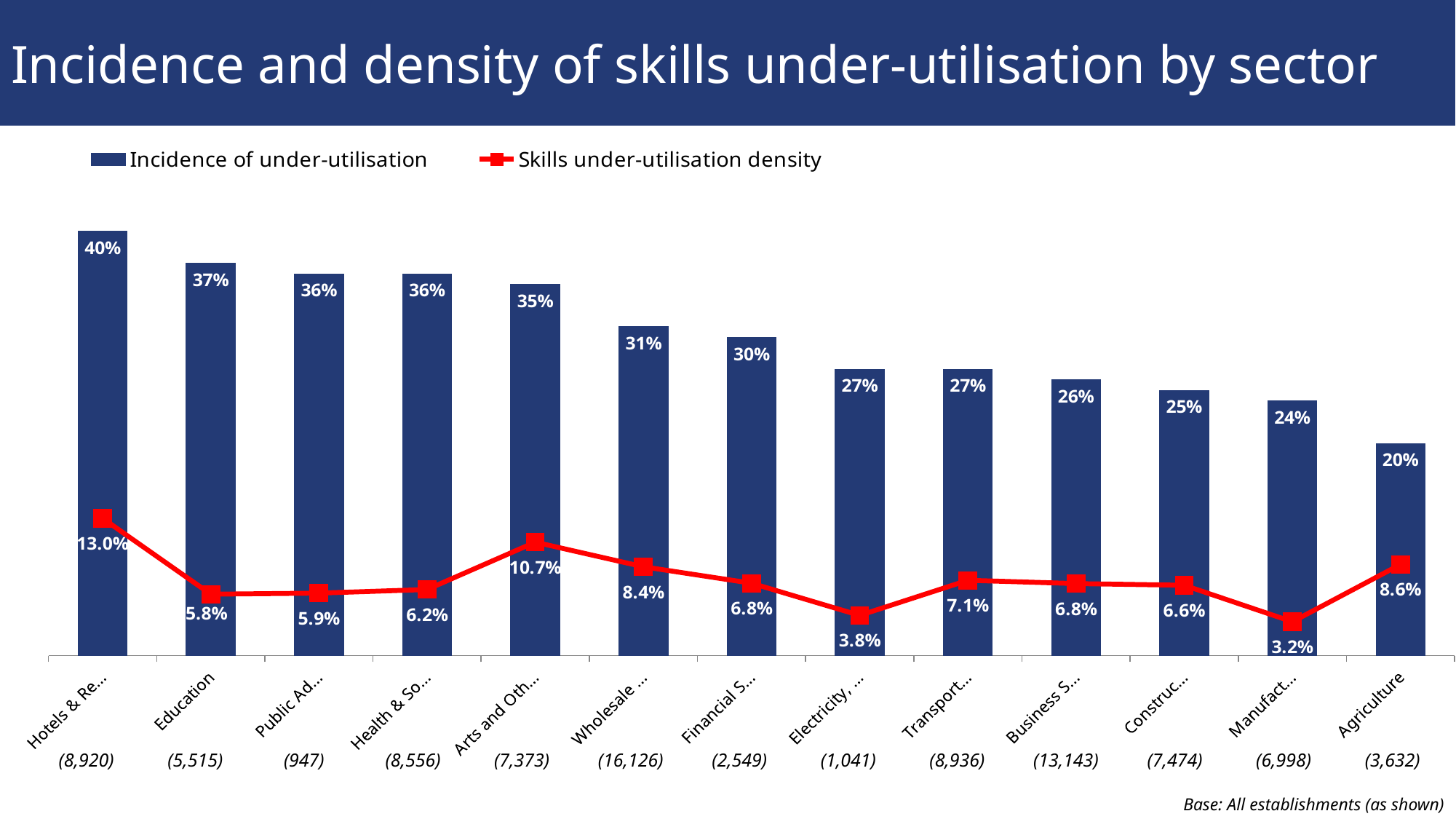
What is the skills under-utilisation density for Agriculture? 8.6% What is the incidence of under-utilisation for Agriculture? 20% What kind of chart is shown on the slide? A bar chart combined with a line chart Do the incidence of under-utilisation bars rise or fall from left to right across the sectors? Fall Which has the higher skills under-utilisation density, Education or Agriculture? Agriculture What is the skills under-utilisation density for Education? 5.8% Which sector has the lowest incidence of under-utilisation? Agriculture What is the difference in incidence of under-utilisation between Education and Agriculture? 17 percentage points How many series does the legend list? 2 How many sectors are plotted along the x axis? 13 What is the incidence of under-utilisation for Education? 37% What are the two entries in the legend? Incidence of under-utilisation; Skills under-utilisation density